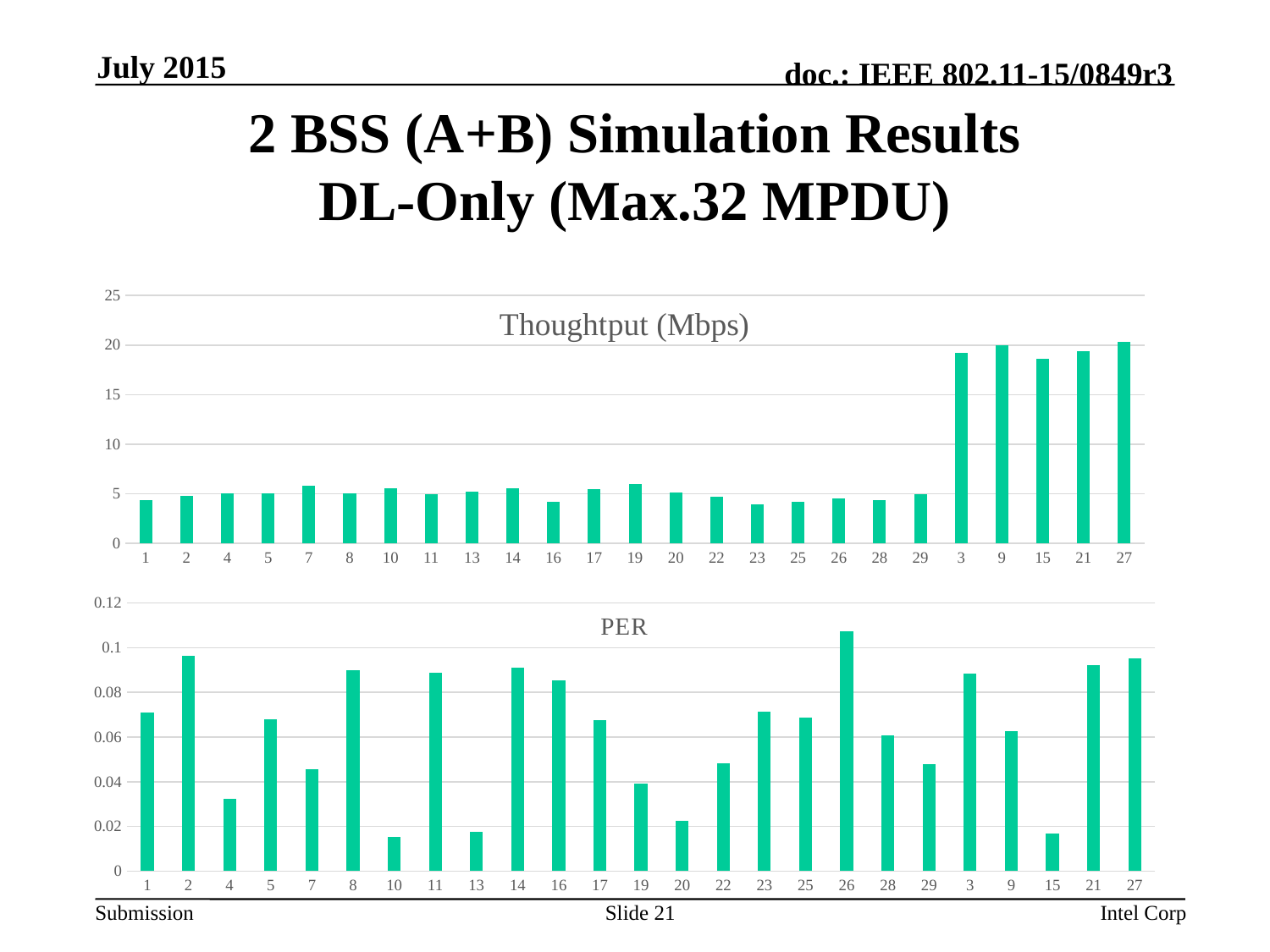
In the PER chart, is the value for category 26 greater or less than 0.1? greater In the Thoughtput (Mbps) chart, is the value for category 3 greater or less than 15? greater What kind of chart is the Thoughtput (Mbps) chart? bar chart What is the title of the bottom chart on the slide? PER In the PER chart, is the value for category 2 greater or less than 0.08? greater In the Thoughtput (Mbps) chart, which has the larger value, category 9 or category 1? 9 How many bars are plotted in the PER chart? 25 What is the title of the top chart on the slide? Thoughtput (Mbps) In the PER chart, which category has the highest value? 26 In the PER chart, which has the larger value, category 2 or category 4? 2